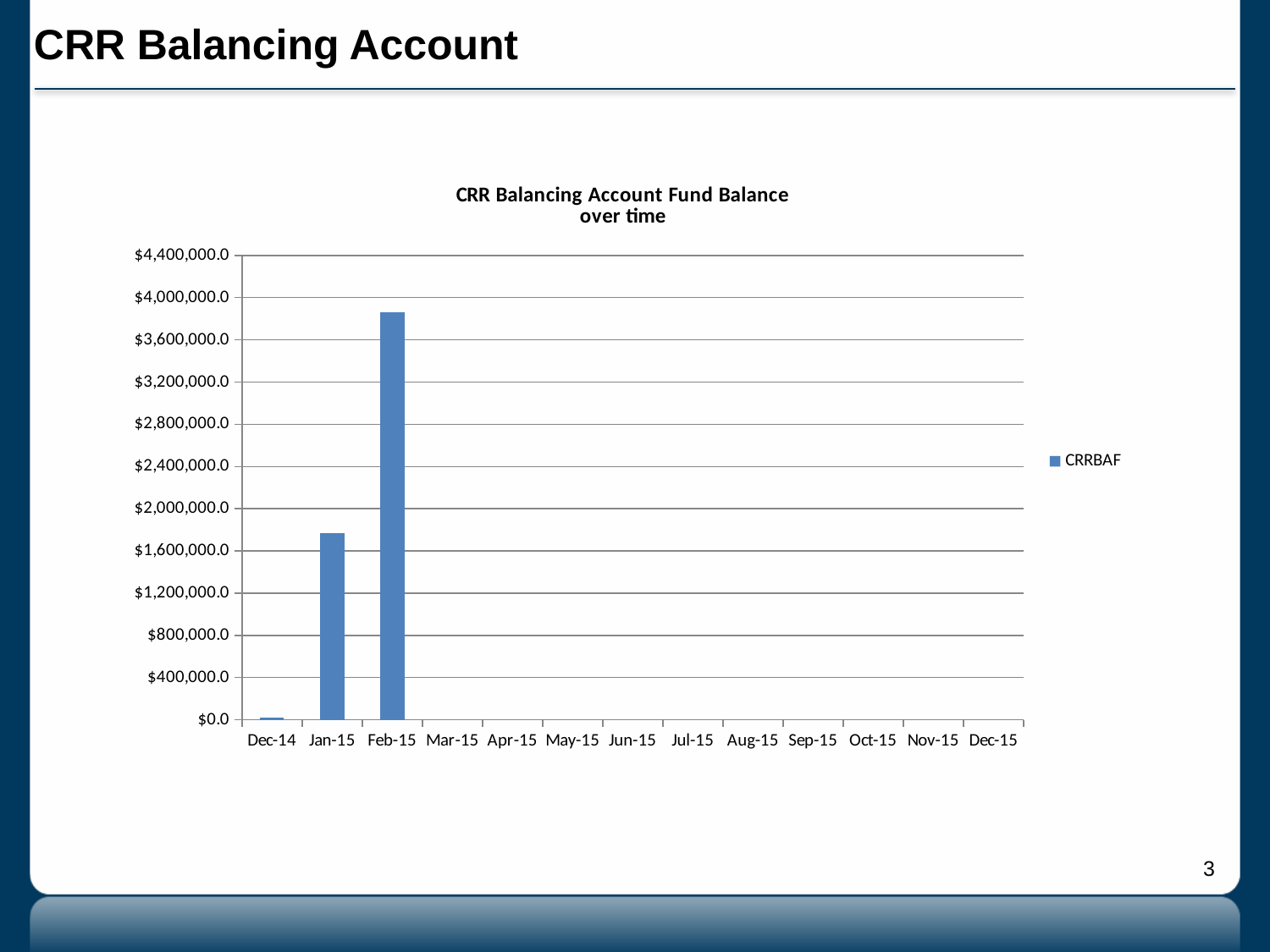
Which month has the highest fund balance? Feb-15 What is the name of the series shown in the legend? CRRBAF Is the value for Feb-15 greater or less than $3,600,000.0? greater How many months are shown on the x axis? 13 How many series does the legend list? 1 Which is larger, the value for Jan-15 or the value for Feb-15? Feb-15 Is the value for Dec-14 greater or less than $400,000.0? less Do the values rise or fall from Dec-14 to Feb-15? Rise Is the value for Jan-15 greater or less than $2,000,000.0? less What is the title of the chart? CRR Balancing Account Fund Balance over time What kind of chart is shown on the slide? Bar chart